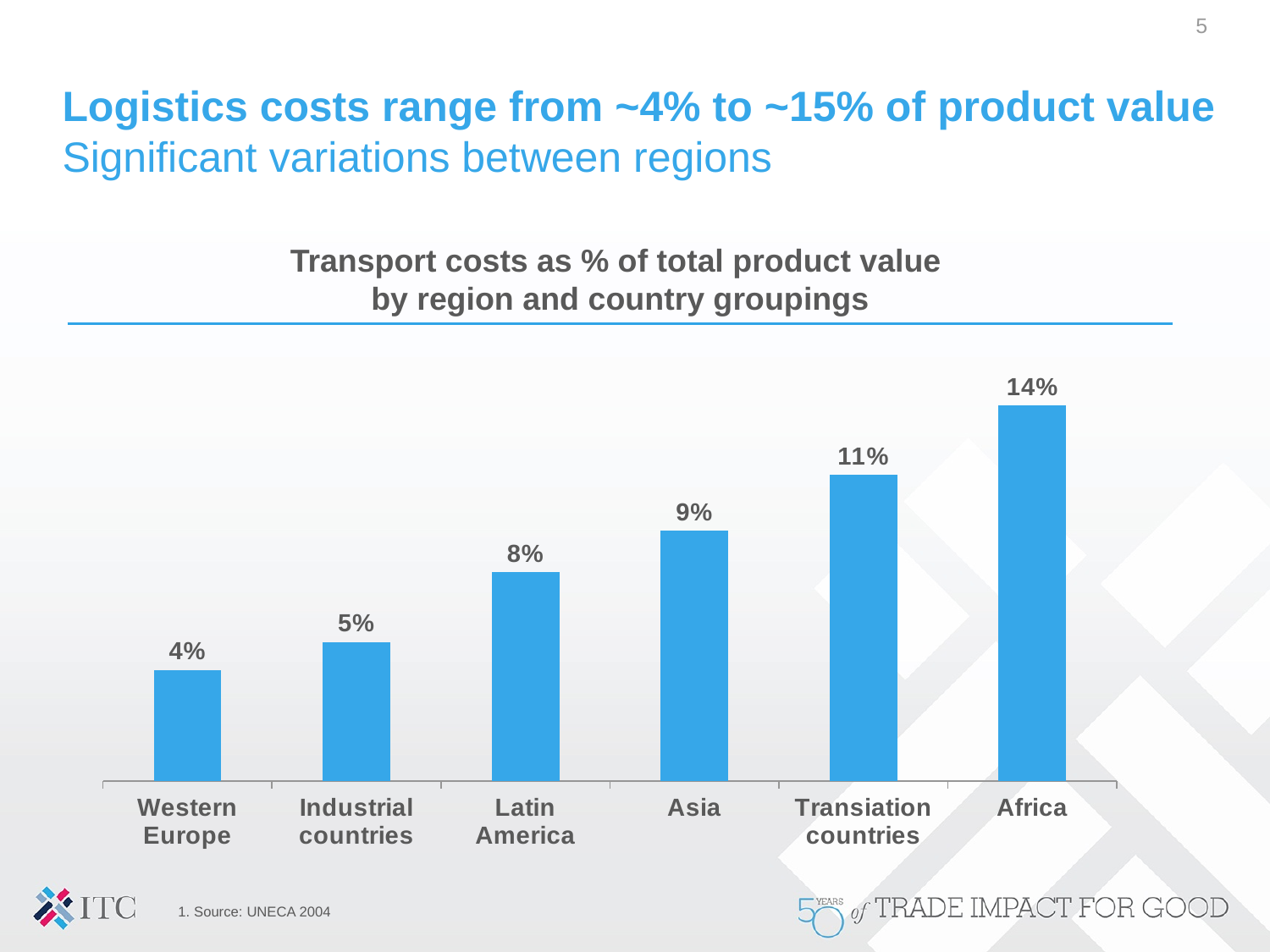
What is the value shown for Asia? 9% What kind of chart is shown on the slide? Bar chart Do the values rise or fall from left to right across the x axis? Rise How many regions or country groupings are shown in the chart? 6 What is the transport cost as % of total product value for Africa? 14% What is the transport cost as % of total product value for Western Europe? 4% Which region or country grouping has the lowest transport cost as % of product value? Western Europe What is the difference between the values for Latin America and Industrial countries? 3% What is the value shown for Transiation countries? 11% What is the difference between the values for Africa and Western Europe? 10% Which region or country grouping has the highest transport cost as % of product value? Africa Which has a higher value, Asia or Latin America? Asia